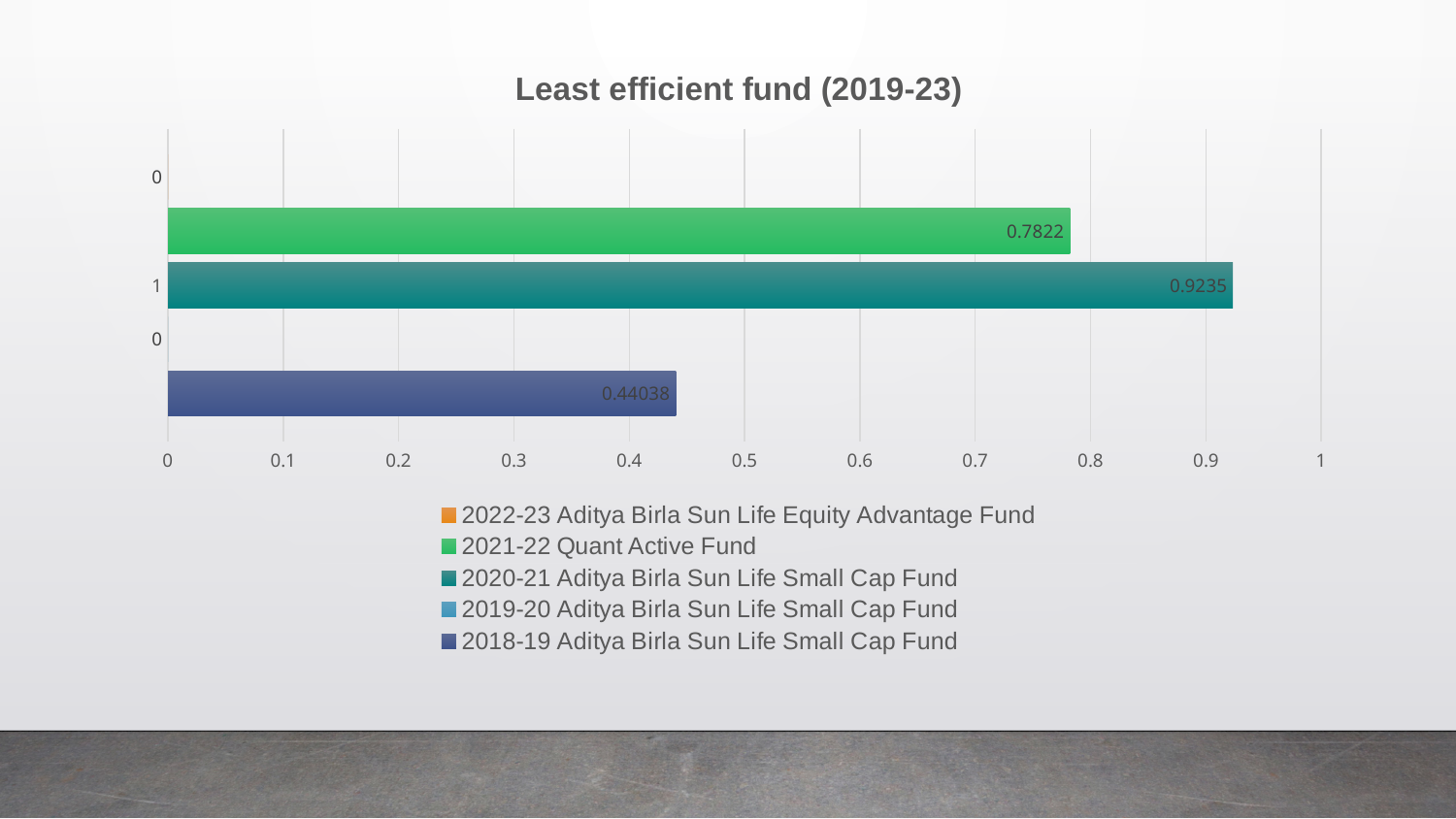
What is the value for 2018-19 Aditya Birla Sun Life Small Cap Fund? 0.44038 What is the title of the chart? Least efficient fund (2019-23) Which is larger, the value for 2021-22 Quant Active Fund or the value for 2018-19 Aditya Birla Sun Life Small Cap Fund? 2021-22 Quant Active Fund Which of the three plotted bars has the lowest value? 2018-19 Aditya Birla Sun Life Small Cap Fund How many series does the legend list? 5 What colour is the bar for 2021-22 Quant Active Fund? green Is the value for 2018-19 Aditya Birla Sun Life Small Cap Fund greater or less than 0.5? less Which series has the highest value? 2020-21 Aditya Birla Sun Life Small Cap Fund What is the value for 2020-21 Aditya Birla Sun Life Small Cap Fund? 0.9235 What is the value for 2021-22 Quant Active Fund? 0.7822 What type of chart is shown on the slide? bar chart What is the difference between the values for 2020-21 Aditya Birla Sun Life Small Cap Fund and 2021-22 Quant Active Fund? 0.1413